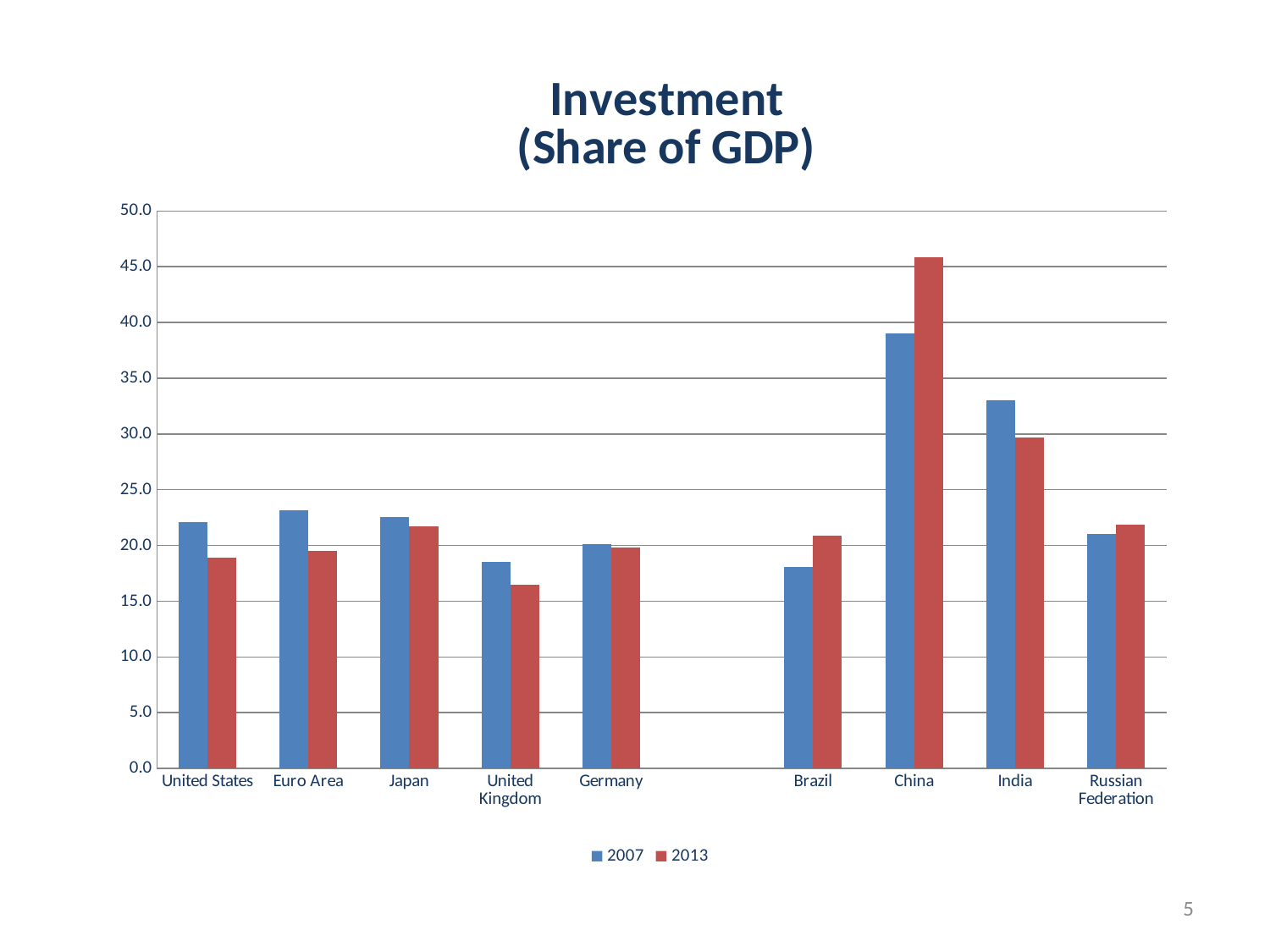
What kind of chart is shown on the slide? bar chart Is the 2007 value for the Euro Area greater or less than 20? greater Is the 2007 value for India greater or less than 30? greater Is the 2013 value for the United Kingdom greater or less than 20? less What is the title of the chart? Investment (Share of GDP) Which country has the lowest investment share of GDP in 2013? United Kingdom For India, which year has the larger investment share, 2007 or 2013? 2007 For Brazil, which year has the larger investment share, 2007 or 2013? 2013 How many series does the legend list? 2 How many countries or regions are labeled on the x axis? 9 Which country has the highest investment share of GDP in 2013? China